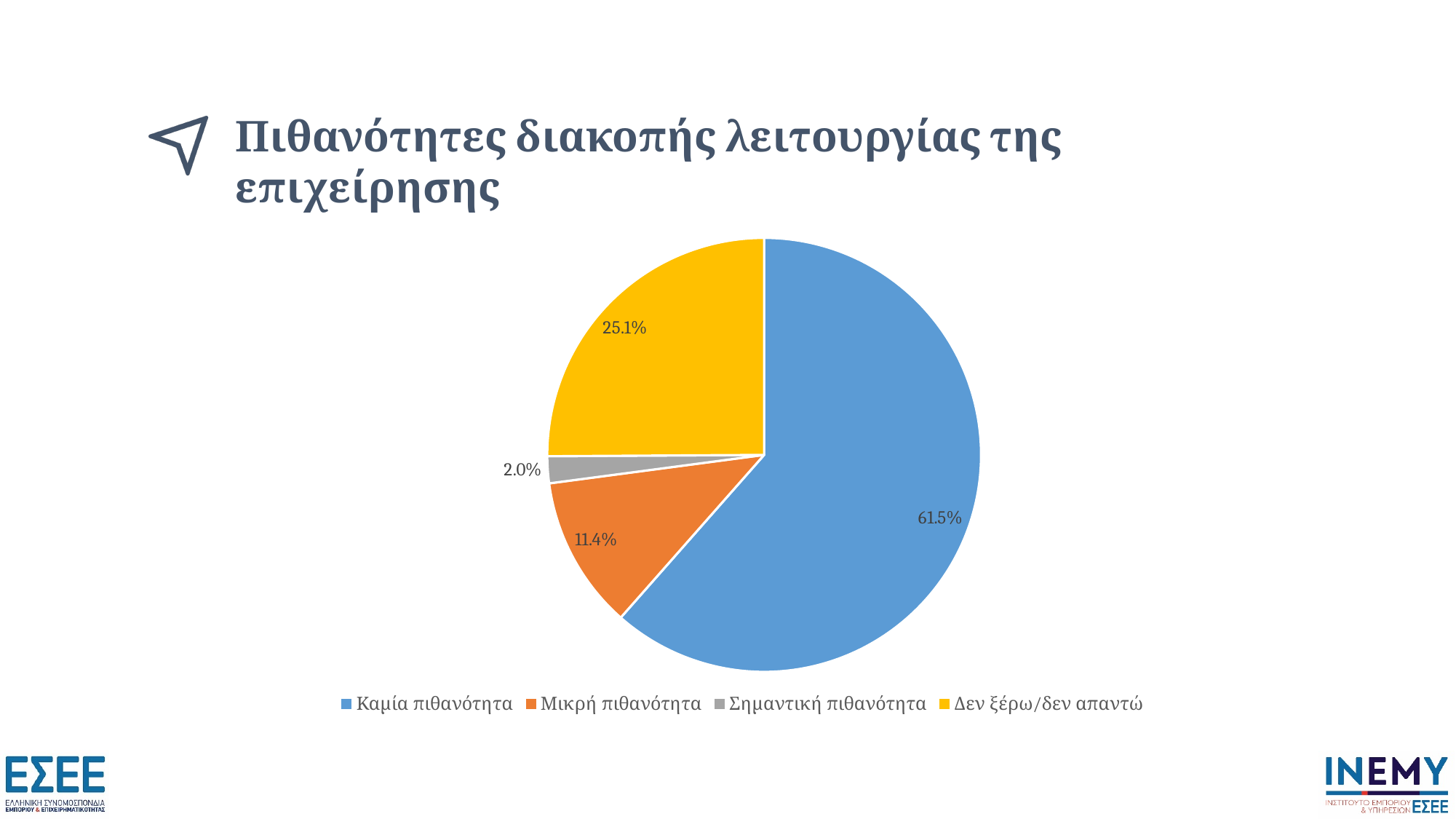
What colour is the slice for Δεν ξέρω/δεν απαντώ? Yellow Which category has the largest slice of the pie? Καμία πιθανότητα What share of the pie does Καμία πιθανότητα have? 61.5% What is the title of the chart on the slide? Πιθανότητες διακοπής λειτουργίας της επιχείρησης Which is larger, the slice for Μικρή πιθανότητα or the slice for Δεν ξέρω/δεν απαντώ? Δεν ξέρω/δεν απαντώ What is the difference in percentage points between Καμία πιθανότητα and Δεν ξέρω/δεν απαντώ? 36.4 Which category has the smallest slice of the pie? Σημαντική πιθανότητα How many slices does the pie chart have? 4 What share of the pie does Μικρή πιθανότητα have? 11.4% What share of the pie does Δεν ξέρω/δεν απαντώ have? 25.1% What kind of chart is shown on the slide? Pie chart What share of the pie does Σημαντική πιθανότητα have? 2.0%